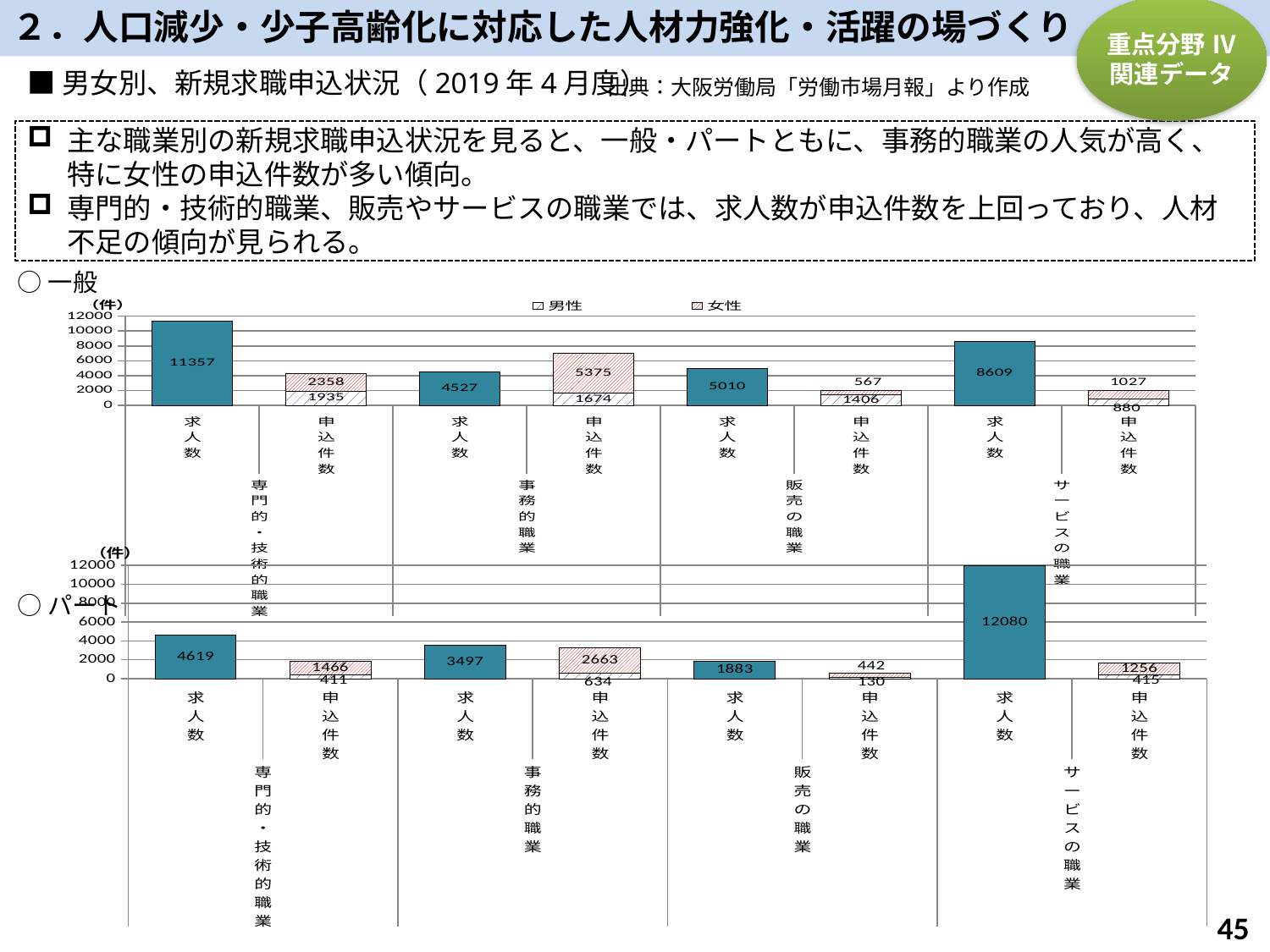
In the パート chart (bottom), what is the total 申込件数 (男性 plus 女性) for 専門的・技術的職業? 1877 In the 一般 chart (top), which occupation has the highest 求人数? 専門的・技術的職業 In the パート chart (bottom), what is the 求人数 value for サービスの職業? 12080 In the パート chart (bottom), which occupation has the lowest 求人数? 販売の職業 In the 一般 chart (top), what is the difference between the 求人数 for サービスの職業 and the 求人数 for 事務的職業? 4082 What kind of chart is the パート chart (bottom)? Bar chart In the 一般 chart (top), what is the total 申込件数 (男性 plus 女性) for 事務的職業? 7049 How many series does the legend of the 一般 chart (top) list? 2 In the パート chart (bottom), which is larger for 事務的職業: the 女性 申込件数 or the 男性 申込件数? 女性 申込件数 In the パート chart (bottom), what is the 男性 申込件数 value for 販売の職業? 130 In the 一般 chart (top), what is the 女性 申込件数 value for 事務的職業? 5375 In the 一般 chart (top), what is the 求人数 value for 専門的・技術的職業? 11357